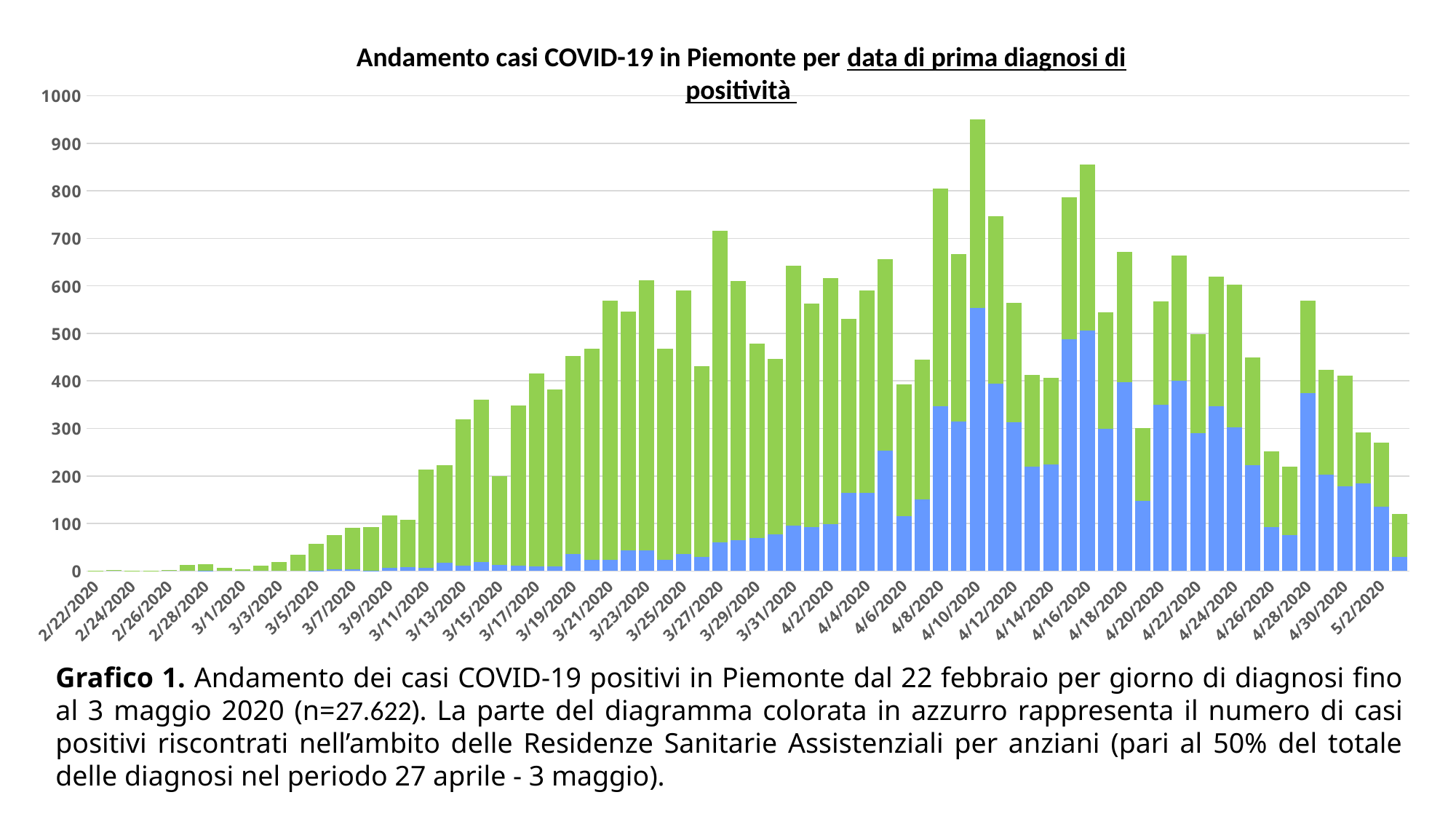
Which date has the tallest bar in the chart? 4/10/2020 Which date has the taller bar, 3/27/2020 or 3/29/2020? 3/27/2020 Is the total value for 5/2/2020 greater or less than 200? greater Is the total value for 3/5/2020 greater or less than 100? less Is the total value for 3/27/2020 greater or less than 600? greater Do the bar totals generally rise or fall from 2/22/2020 to 4/10/2020? rise What colour represents the cases found in the Residenze Sanitarie Assistenziali (RSA)? azzurro (blue) Which date has the taller bar, 4/10/2020 or 4/16/2020? 4/10/2020 What kind of chart is shown on the slide? bar chart What is the highest value shown on the vertical axis? 1000